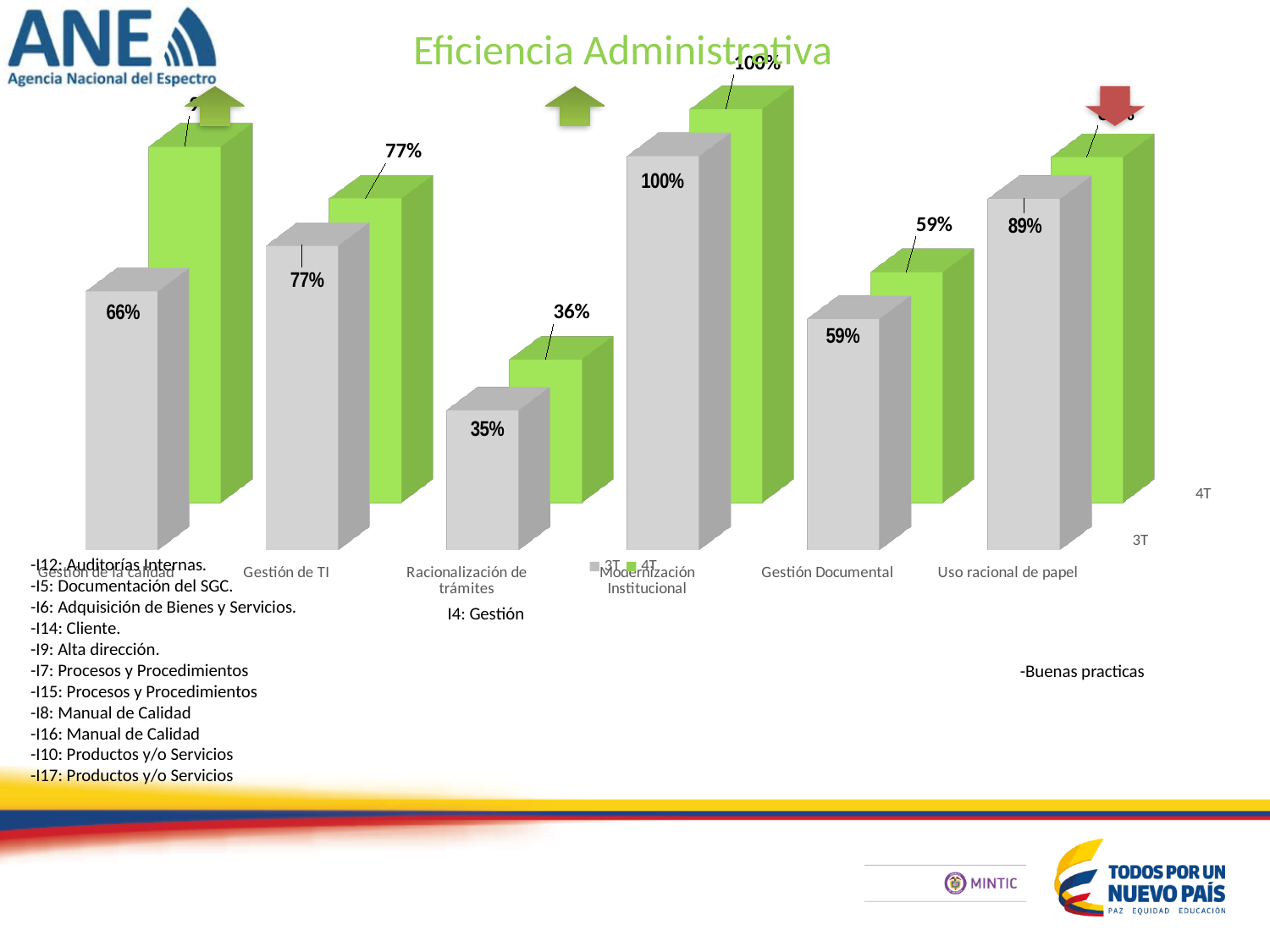
What kind of chart is shown on the slide? bar chart What is the 4T value for Gestión Documental? 59% Which category has the lowest 3T value? Racionalización de trámites What is the 4T value for Racionalización de trámites? 36% What is the 3T value for Racionalización de trámites? 35% What is the 3T value for Gestión de la calidad? 66% What is the difference between the 3T values for Gestión de TI and Racionalización de trámites? 42 percentage points Which category has the highest 3T value? Modernización Institucional How many categories are shown along the x axis of the chart? 6 What is the 3T value for Uso racional de papel? 89% What is the 3T value for Modernización Institucional? 100% How many series does the chart legend list? 2